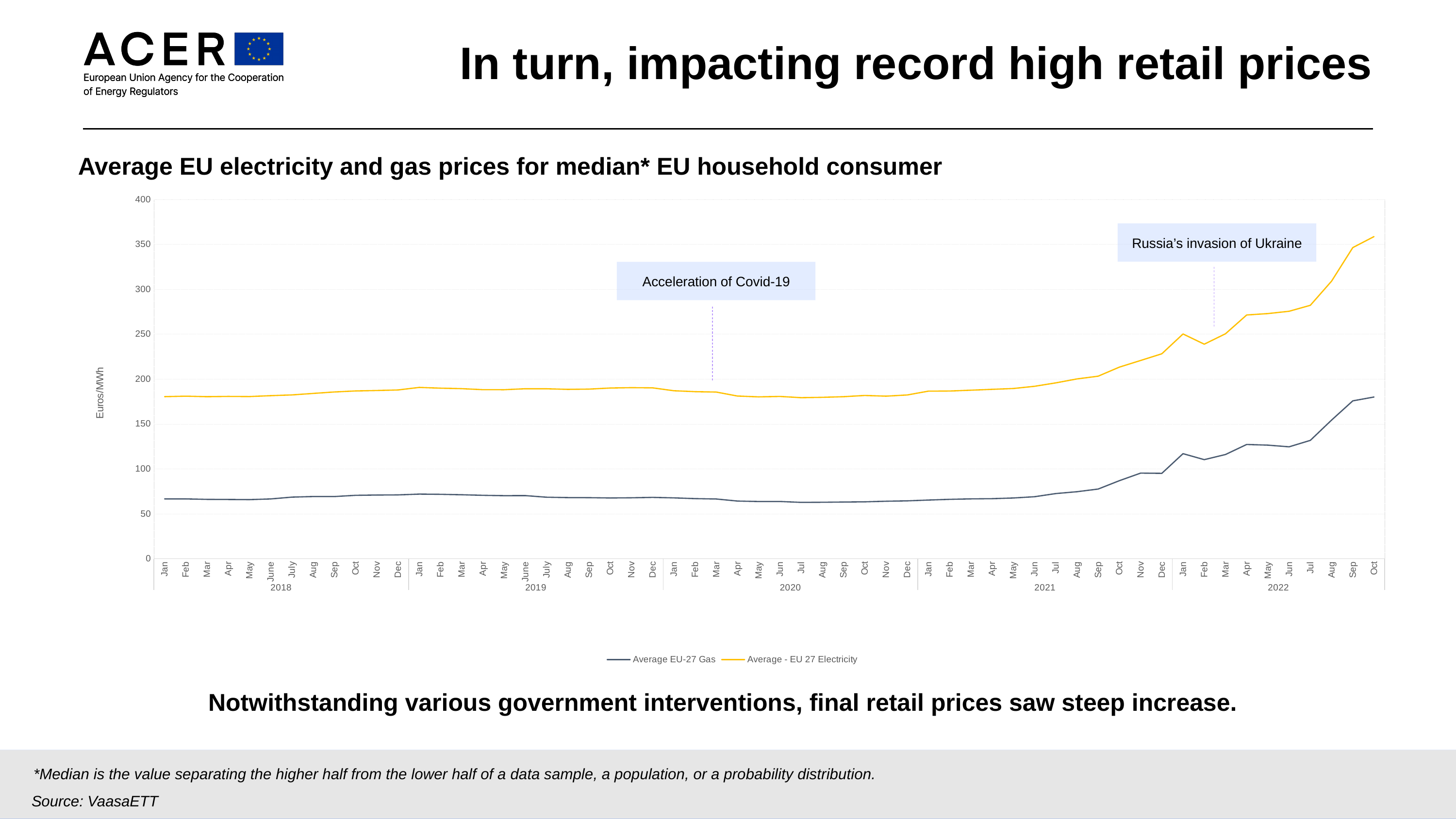
What kind of chart is shown on the slide? Line chart In which month and year does the Average EU-27 Gas series reach its highest value? Oct 2022 Is the value for Average - EU 27 Electricity in Oct 2022 greater or less than 300? greater Is the value for Average EU-27 Gas in Oct 2022 greater or less than 150? greater How many series does the legend list? 2 What two events are annotated on the chart? Acceleration of Covid-19 and Russia's invasion of Ukraine In which month and year does the Average - EU 27 Electricity series reach its highest value? Oct 2022 How many years are covered on the x axis? 5 Is the value for Average EU-27 Gas in Jan 2018 greater or less than 100? less What are the two series named in the legend? Average EU-27 Gas and Average - EU 27 Electricity Which series has the higher values throughout the chart, gas or electricity? Electricity How do the electricity and gas prices change over the course of 2022? They rise